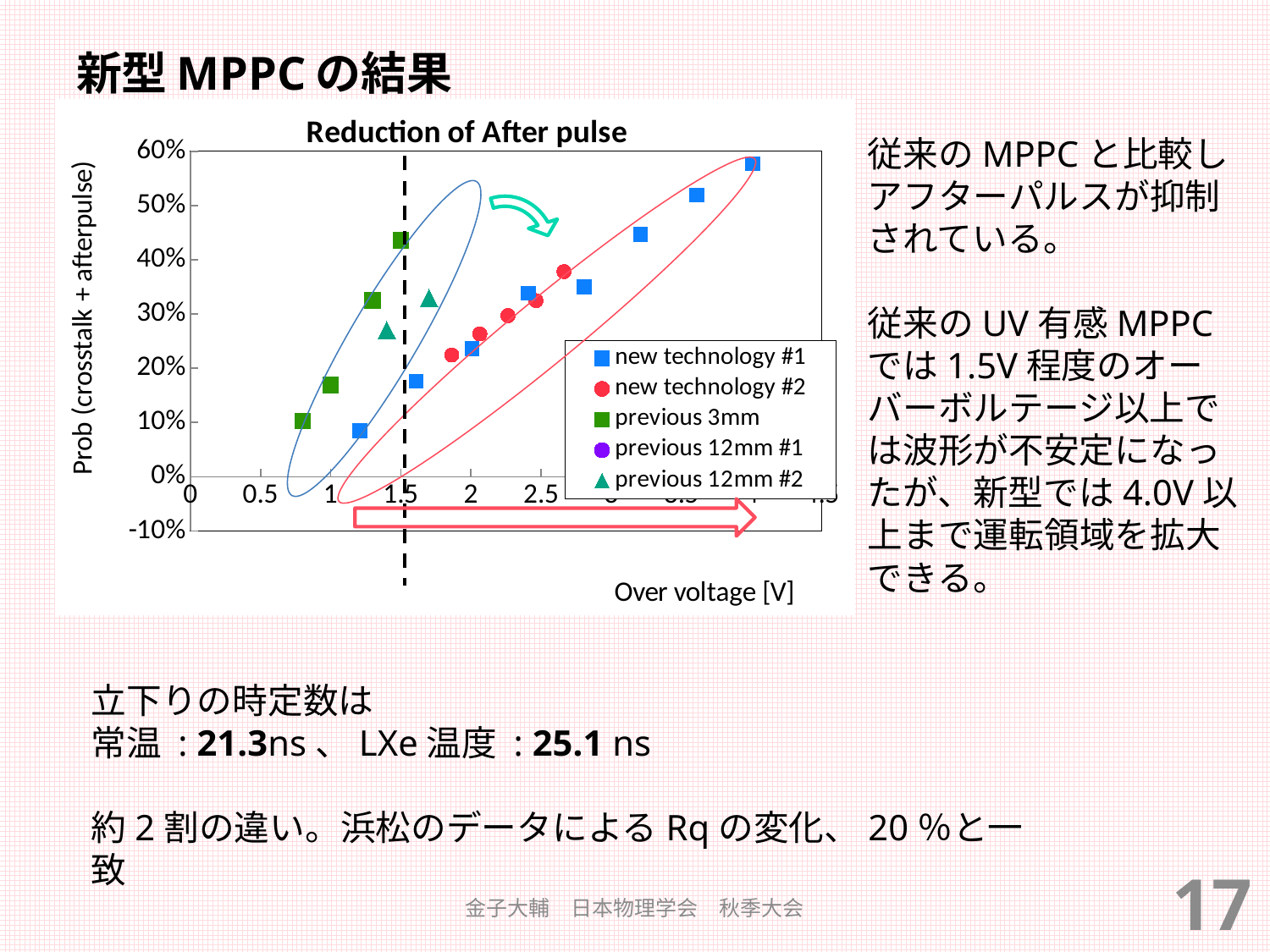
Is the lowest value for new technology #1 greater or less than 10%? less What kind of chart is shown on the slide? scatter chart What is the title of the chart? Reduction of After pulse How many data points are plotted for previous 12mm #2? 2 Is the highest value for new technology #1 greater or less than 50%? greater How many data points are plotted for previous 3mm? 4 Which series reaches the highest value on the chart? new technology #1 Do the values for new technology #1 rise or fall as over voltage increases? rise Which is larger: the highest value for new technology #1 or the highest value for previous 3mm? new technology #1 What is the label of the x axis of the chart? Over voltage [V] Is the value for previous 3mm at an over voltage of 1.5 V greater or less than 40%? greater How many series does the chart legend list? 5